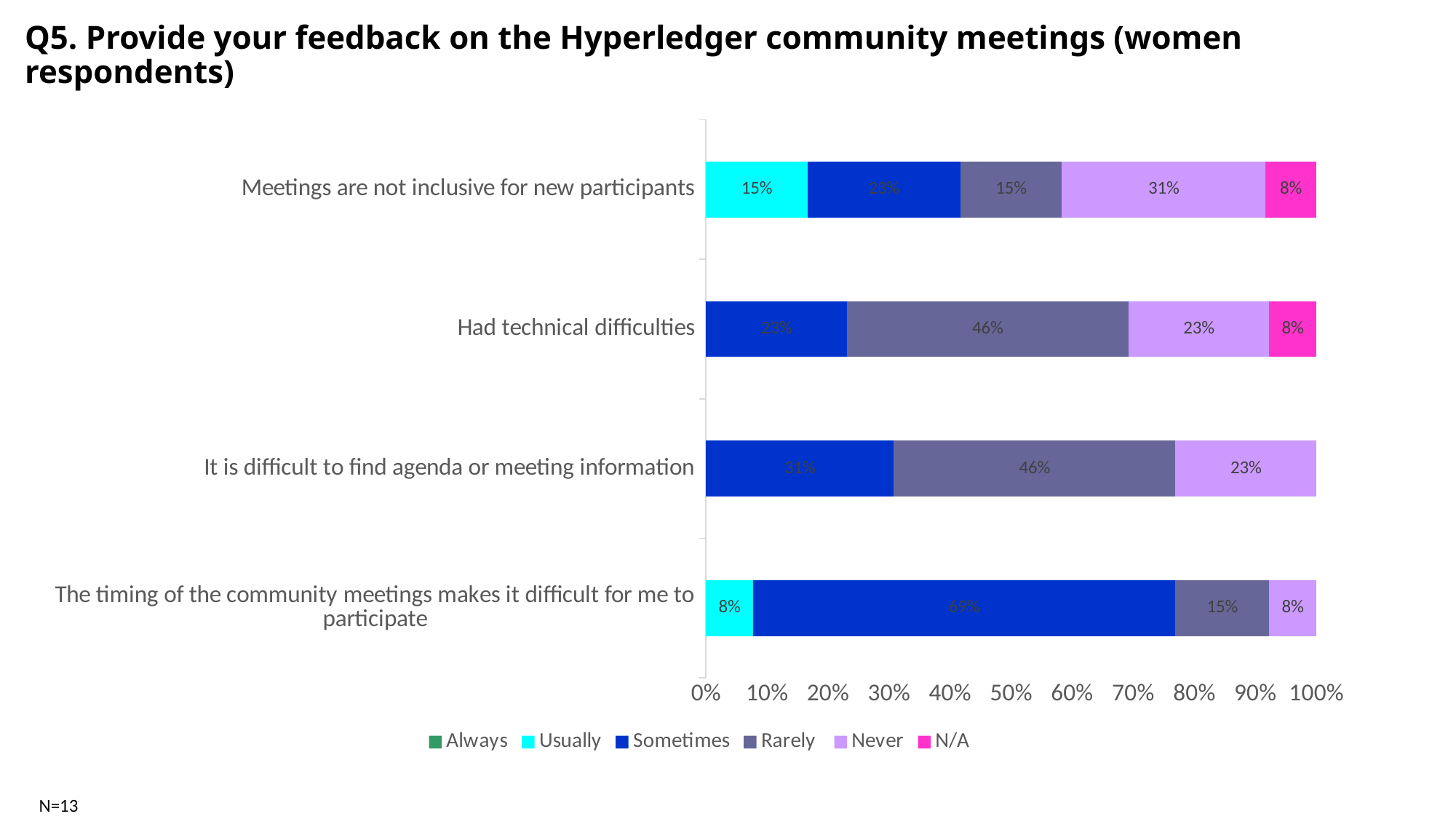
Which is larger: the 'Rarely' value for 'Had technical difficulties' or the 'Rarely' value for 'Meetings are not inclusive for new participants'? Had technical difficulties Which statement has the highest 'Sometimes' value? The timing of the community meetings makes it difficult for me to participate Which statement has the lowest 'Never' value? The timing of the community meetings makes it difficult for me to participate What is the 'Sometimes' value for 'The timing of the community meetings makes it difficult for me to participate'? 69% How many series does the legend list? 6 How many categories (statements) are plotted on the chart? 4 What is the 'Rarely' value for 'Had technical difficulties'? 46% What is the difference between the 'Sometimes' values for 'It is difficult to find agenda or meeting information' and 'Had technical difficulties'? 8% What is the 'Usually' value for 'Meetings are not inclusive for new participants'? 15% What kind of chart is shown on the slide? Stacked bar chart What is the 'Never' value for 'Meetings are not inclusive for new participants'? 31% What is the sample size noted on the slide? N=13